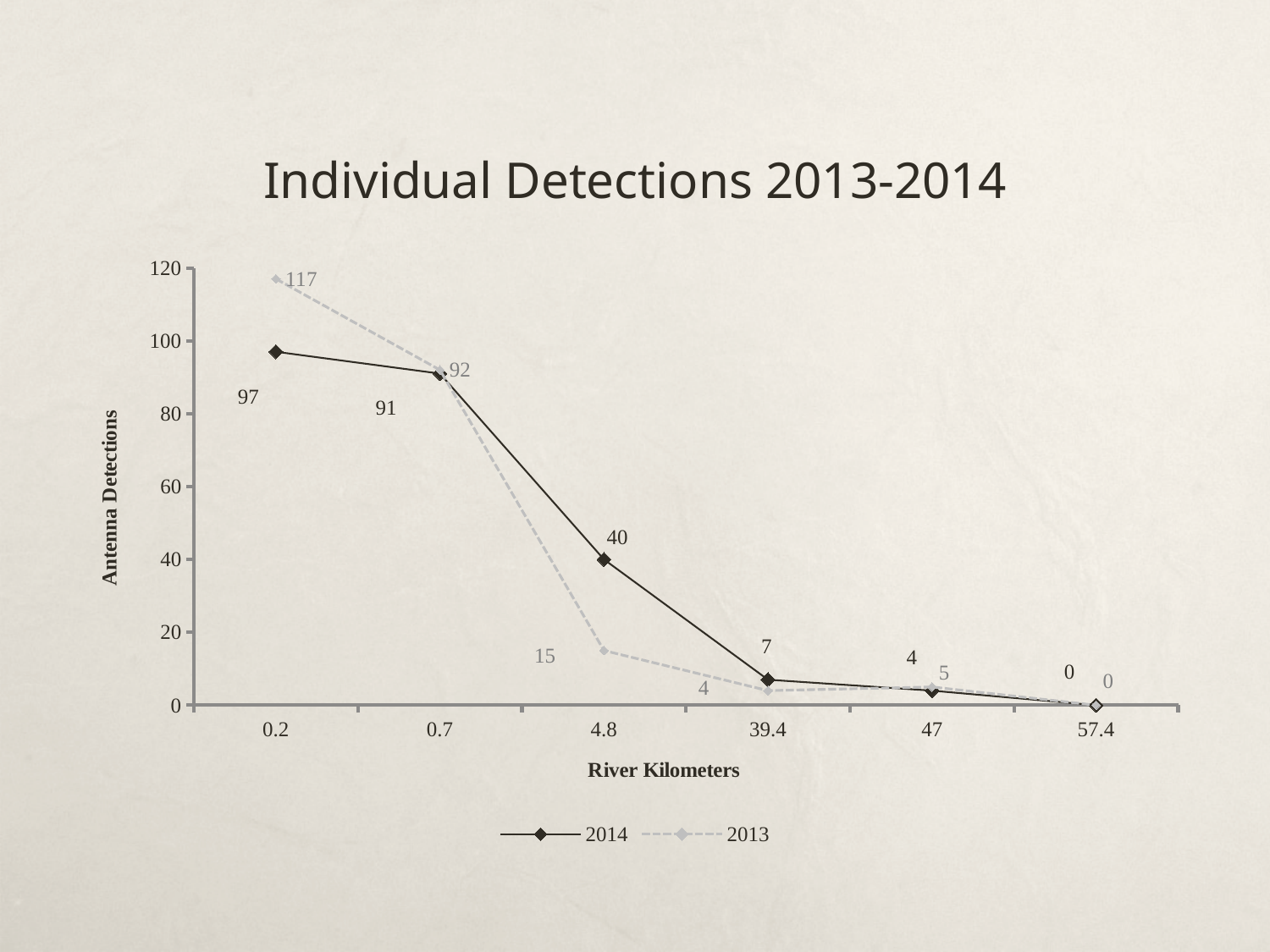
Which series has the larger value at river kilometer 4.8, 2014 or 2013? 2014 What kind of chart is shown on the slide? Line chart At which river kilometer is the 2013 series highest? 0.2 What is the 2013 value at river kilometer 4.8? 15 What is the 2014 value at river kilometer 39.4? 7 At which river kilometer is the 2014 series lowest? 57.4 Do the 2014 values rise or fall as river kilometers increase along the x axis? Fall What is the 2014 value at river kilometer 0.2? 97 How many river kilometer points are plotted along the x axis? 6 What is the title of the chart? Individual Detections 2013-2014 What is the difference between the 2013 and 2014 values at river kilometer 0.2? 20 How many series does the legend list? 2